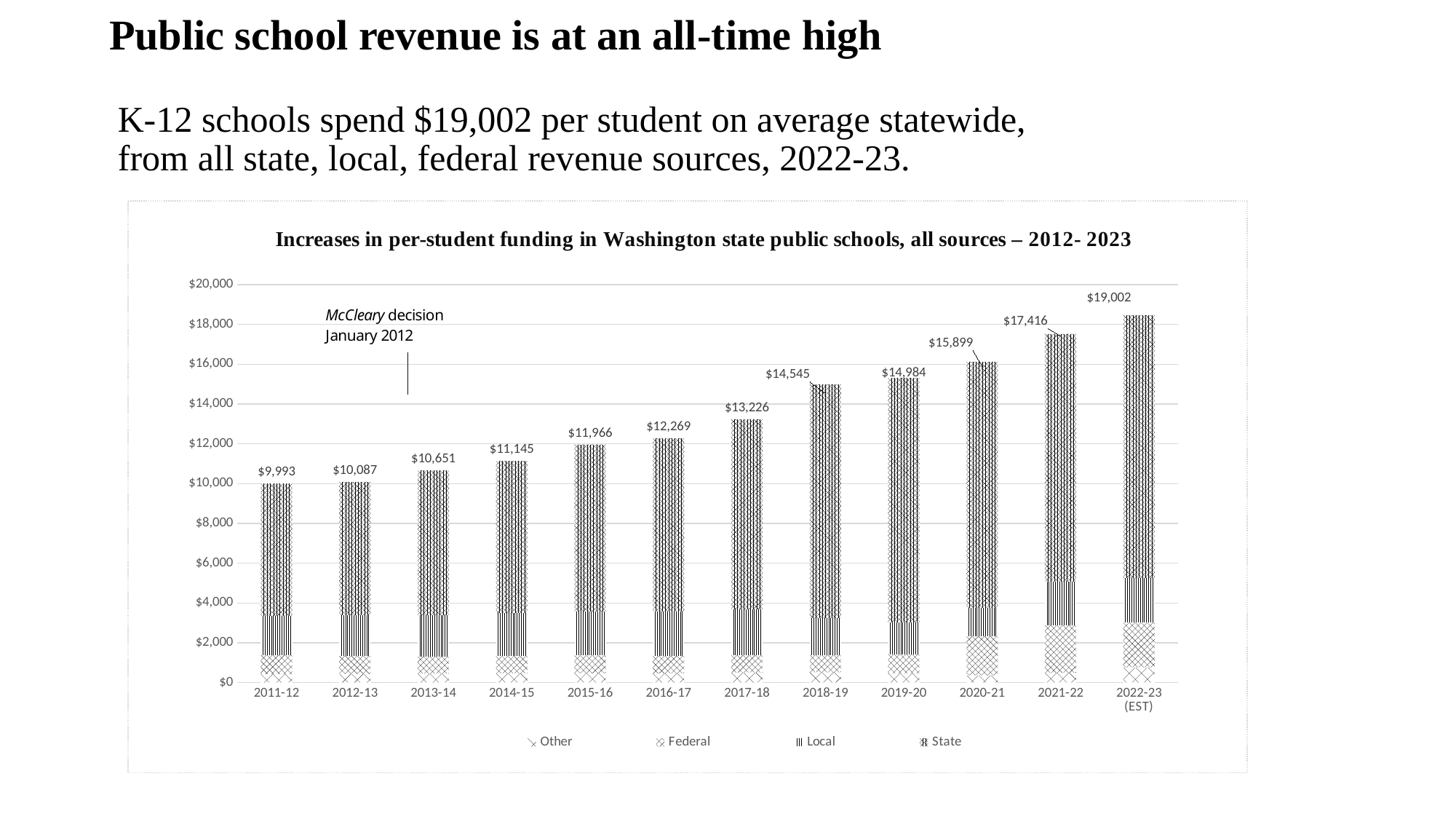
What is the total per-student funding shown for 2011-12? $9,993 Which year has a larger total per-student funding, 2018-19 or 2019-20? 2019-20 How many series does the legend list? 4 Is the total per-student funding for 2015-16 greater or less than $12,000? less What is the difference between the total per-student funding in 2021-22 and in 2020-21? $1,517 What is the total per-student funding shown for 2022-23 (EST)? $19,002 What is the difference between the total per-student funding in 2022-23 (EST) and in 2011-12? $9,009 Which year has the highest total per-student funding? 2022-23 (EST) Do the total per-student funding values rise or fall from 2011-12 to 2022-23 (EST)? rise What is the total per-student funding shown for 2017-18? $13,226 How many school years are shown on the x axis? 12 Which year has the lowest total per-student funding? 2011-12